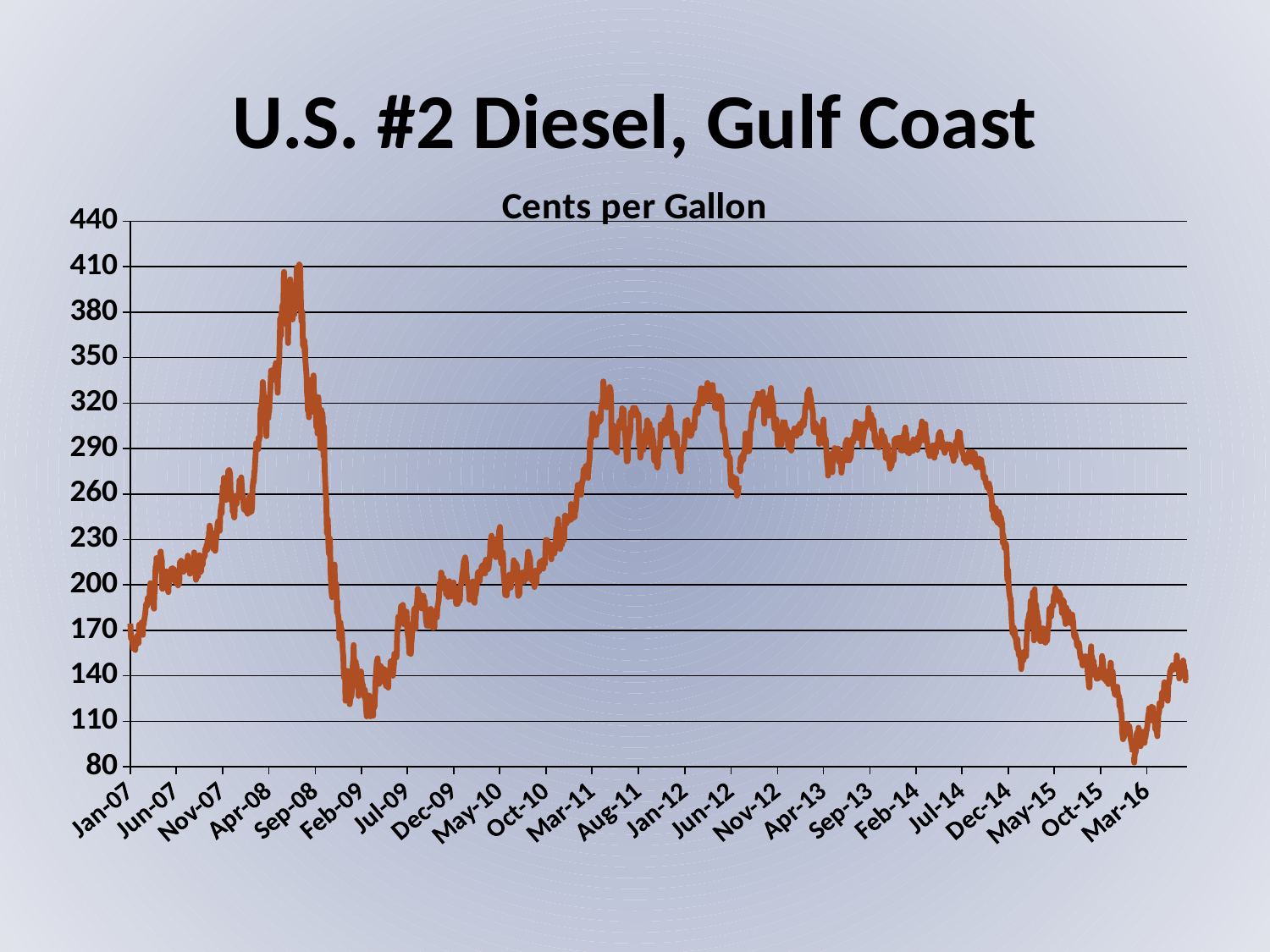
Around which x-axis label does the line reach its highest value? Sep-08 Is the lowest value reached in early 2016 greater or less than 110? less What is the title of the chart? U.S. #2 Diesel, Gulf Coast Does the line generally rise or fall between Jul-14 and Mar-16? fall Is the value around Feb-09 greater or less than 140? less Is the value around Jul-14 greater or less than 260? greater What unit is the chart's vertical axis measured in, according to the subtitle? Cents per Gallon Does the line generally rise or fall between Jan-07 and Sep-08? rise What kind of chart is shown on the slide? line chart Which is higher, the value around Sep-08 or the value around Feb-09? Sep-08